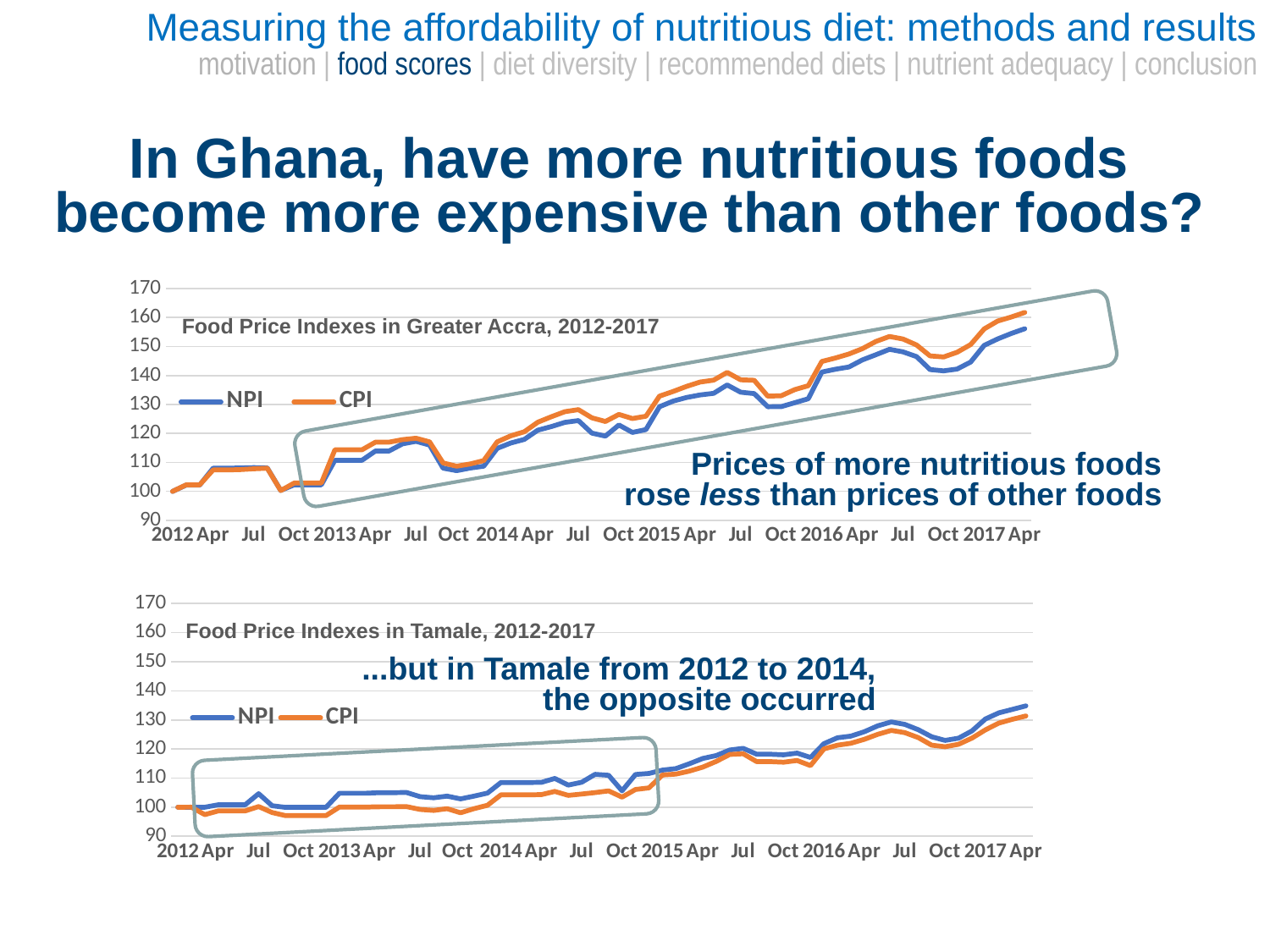
In the Food Price Indexes in Greater Accra, 2012-2017 chart, do the NPI and CPI values generally rise or fall from 2012 to 2017? rise What kind of chart is the Food Price Indexes in Tamale, 2012-2017 chart? line chart What kind of chart is the Food Price Indexes in Greater Accra, 2012-2017 chart? line chart In the Food Price Indexes in Tamale, 2012-2017 chart, is the CPI value at 2014 Apr greater or less than 110? less In the Food Price Indexes in Tamale, 2012-2017 chart, which series is higher at 2014 Apr, NPI or CPI? NPI In the Food Price Indexes in Tamale, 2012-2017 chart, is the NPI value at 2017 Apr greater or less than 120? greater In the Food Price Indexes in Greater Accra, 2012-2017 chart, is the NPI value at 2017 Apr greater or less than 140? greater How many series does the legend of the Food Price Indexes in Tamale, 2012-2017 chart list? 2 In the Food Price Indexes in Greater Accra, 2012-2017 chart, which two series are shown in the legend? NPI and CPI In the Food Price Indexes in Greater Accra, 2012-2017 chart, which series is higher at 2017 Apr, NPI or CPI? CPI How many series does the legend of the Food Price Indexes in Greater Accra, 2012-2017 chart list? 2